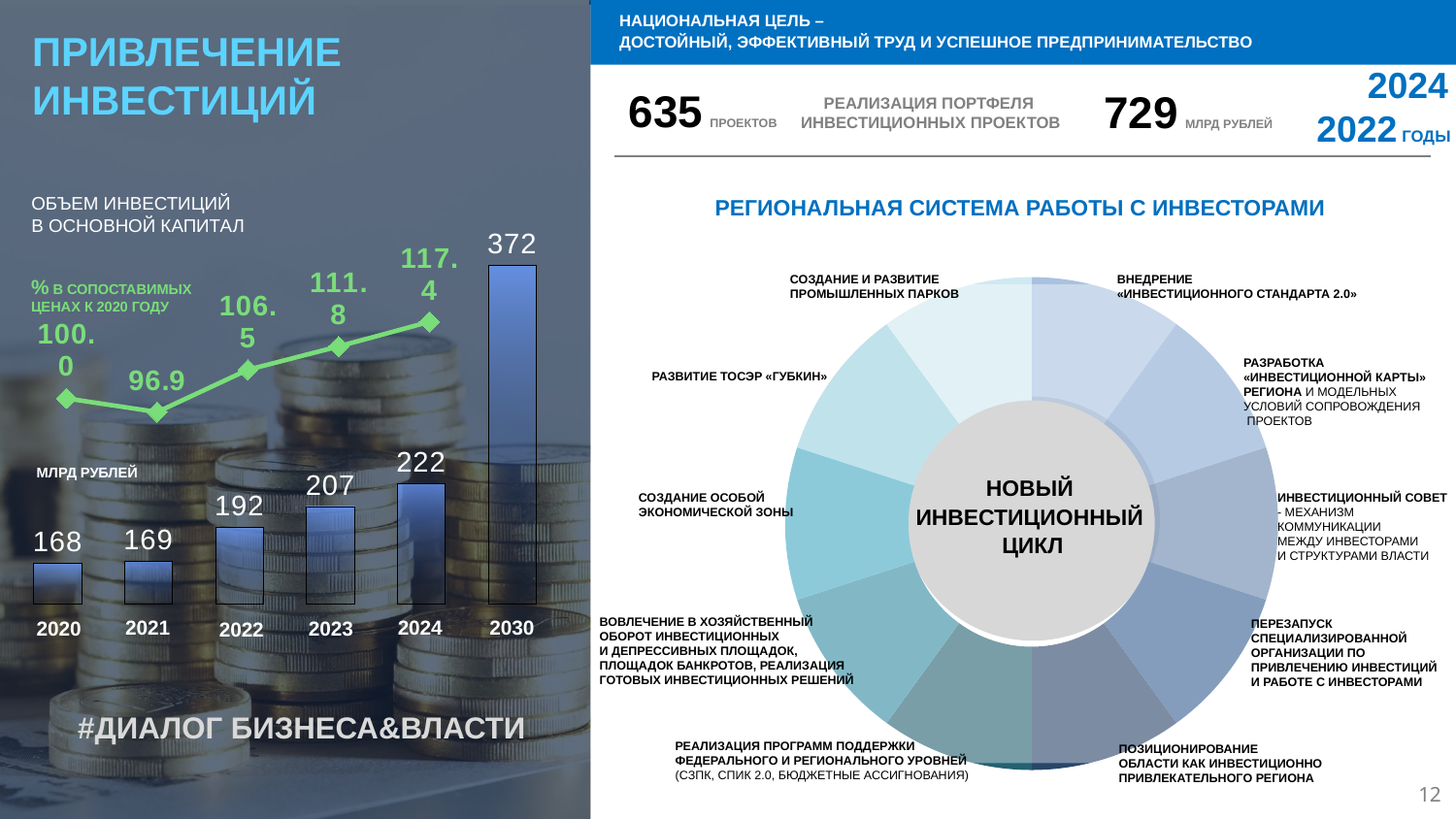
In the 'Объем инвестиций в основной капитал' chart, what is the percentage value (в сопоставимых ценах к 2020 году) for 2024? 117.4 What type of chart is used for the 'Объем инвестиций в основной капитал' data? Combined bar and line chart In the 'Объем инвестиций в основной капитал' chart, what is the difference in млрд рублей between 2030 and 2024? 150 In the 'Объем инвестиций в основной капитал' chart, which year has the highest value in млрд рублей? 2030 In the 'Объем инвестиций в основной капитал' chart, do the bar values in млрд рублей rise or fall from 2020 to 2030? rise In the 'Объем инвестиций в основной капитал' chart, what is the value in млрд рублей for 2030? 372 In the 'Объем инвестиций в основной капитал' chart, which is larger in млрд рублей: 2021 or 2023? 2023 In the 'Объем инвестиций в основной капитал' chart, which year has the lowest value in млрд рублей? 2020 In the 'Объем инвестиций в основной капитал' chart, what is the difference in млрд рублей between 2023 and 2022? 15 How many years are shown on the x axis of the 'Объем инвестиций в основной капитал' chart? 6 In the 'Объем инвестиций в основной капитал' chart, what is the value in млрд рублей for 2022? 192 In the 'Объем инвестиций в основной капитал' chart, what is the percentage value (в сопоставимых ценах к 2020 году) for 2021? 96.9